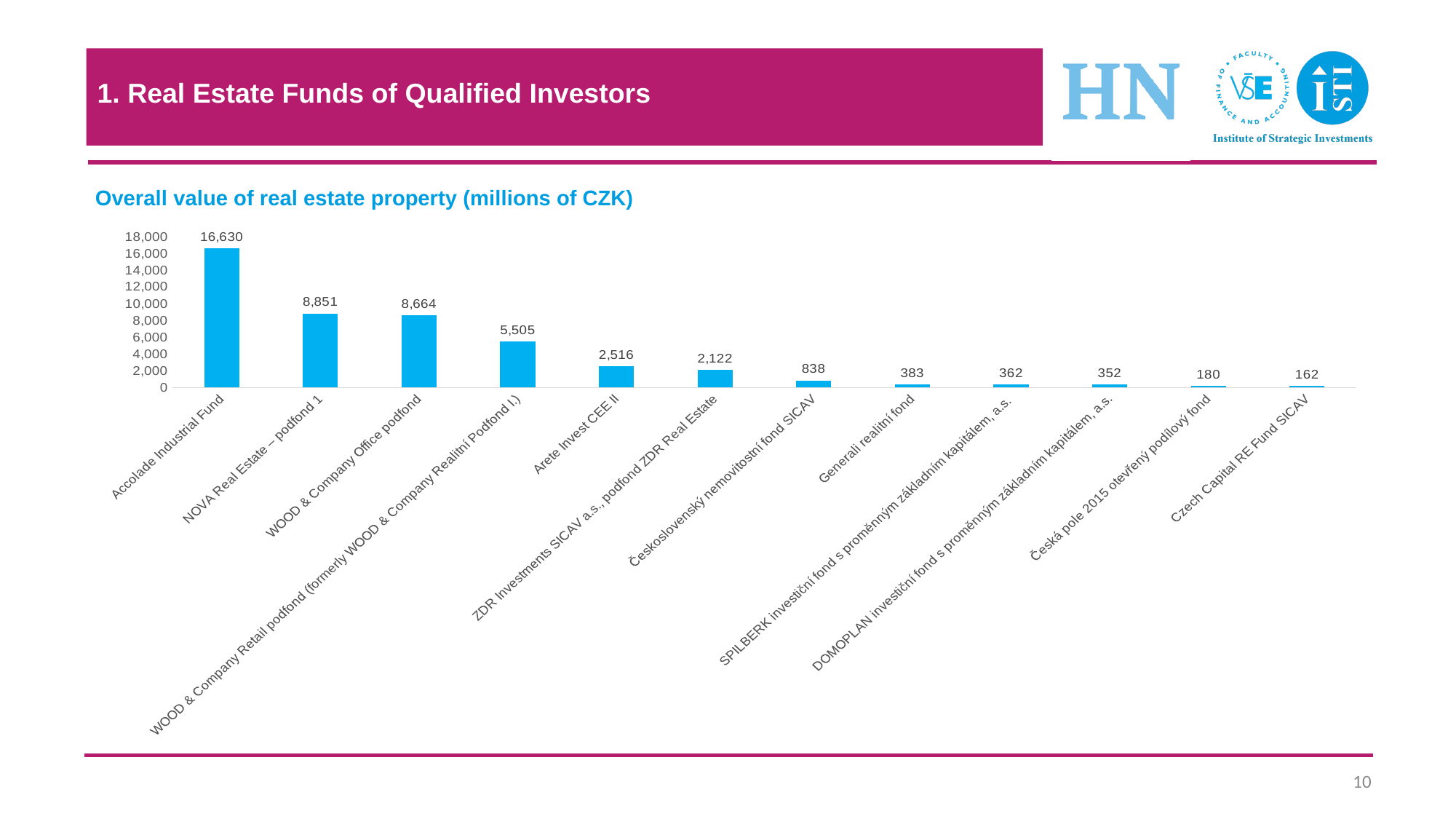
Which fund has the lowest overall value of real estate property? Czech Capital RE Fund SICAV How many funds are shown in the chart? 12 What type of chart is used to show the overall value of real estate property? Bar chart What is the difference between the values for Accolade Industrial Fund and NOVA Real Estate – podfond 1? 7,779 What value is shown for Arete Invest CEE II? 2,516 What is the value for Generali realitní fond? 383 Is the value for Československý nemovitostní fond SICAV greater or less than 2,000? less Which has a larger value, NOVA Real Estate – podfond 1 or WOOD & Company Office podfond? NOVA Real Estate – podfond 1 Which fund has the highest overall value of real estate property? Accolade Industrial Fund What is the difference between the values for Arete Invest CEE II and ZDR Investments SICAV a.s., podfond ZDR Real Estate? 394 Do the values rise or fall moving from left to right along the x axis? Fall What is the overall value of real estate property for Accolade Industrial Fund? 16,630